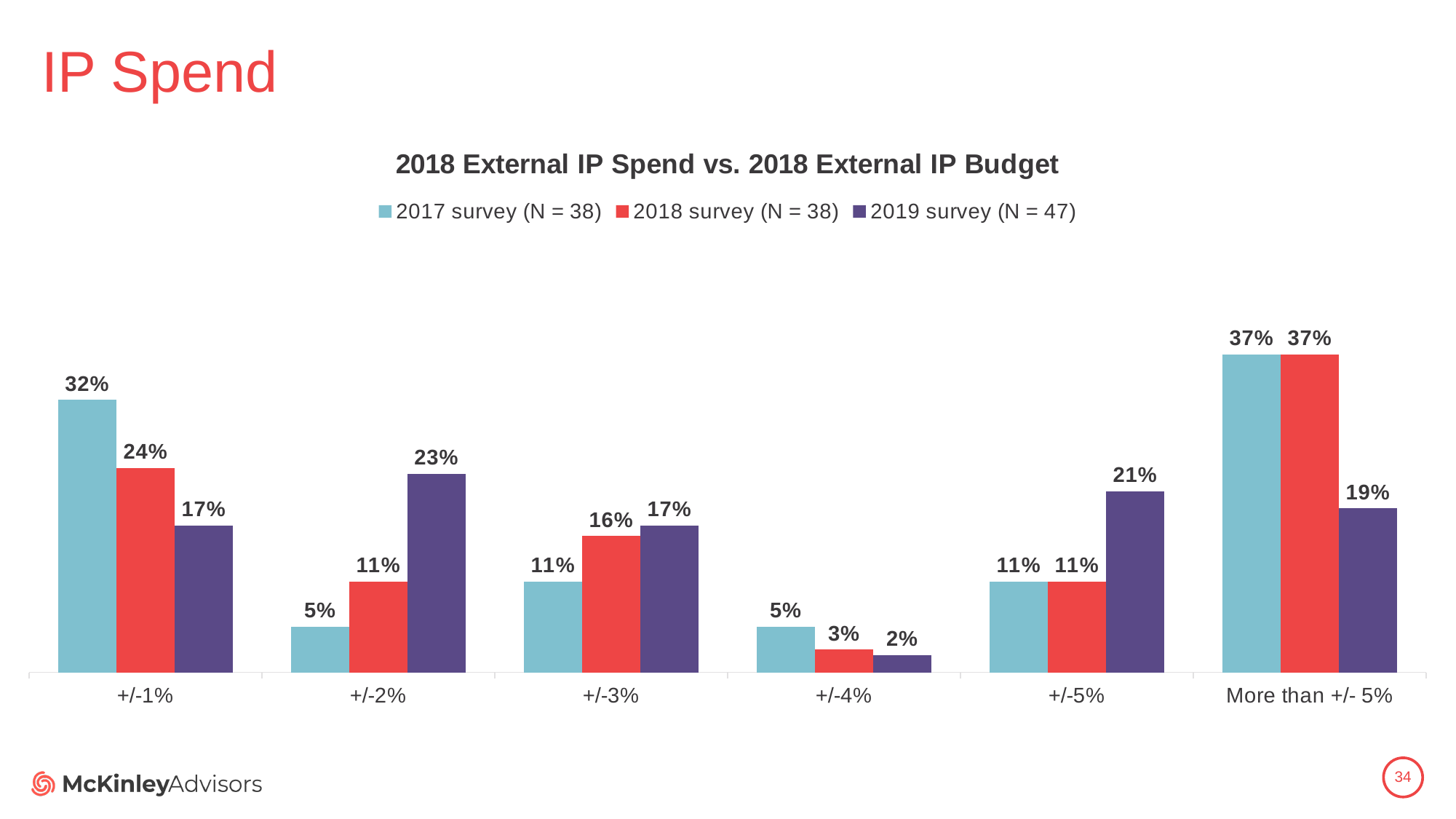
What is the difference between the 2017 survey and 2019 survey values in the +/-1% category? 15% What is the value for the 2017 survey in the +/-1% category? 32% How many categories are shown on the x axis? 6 Which category has the highest value for the 2019 survey? +/-2% What is the value for the 2018 survey in the +/-4% category? 3% What kind of chart is shown on the slide? Bar chart Which category has the lowest value for the 2017 survey? +/-2% and +/-4% (tied at 5%) Which is larger in the +/-5% category: the 2019 survey value or the 2018 survey value? 2019 survey What is the value for the 2019 survey in the More than +/- 5% category? 19% How many series does the legend list? 3 What is the value for the 2019 survey in the +/-2% category? 23% What is the title of the chart? 2018 External IP Spend vs. 2018 External IP Budget